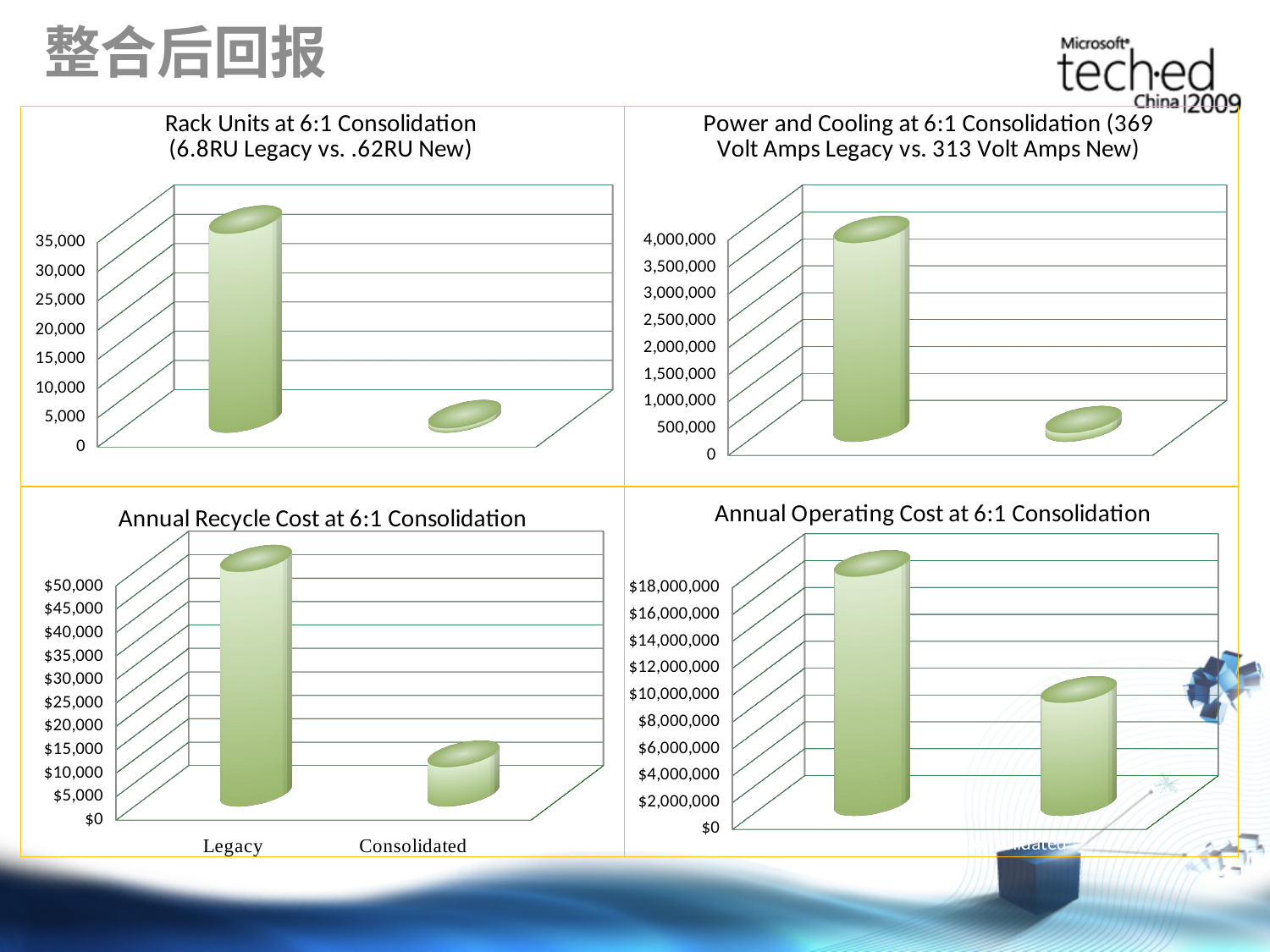
In the 'Annual Recycle Cost at 6:1 Consolidation' chart, is the value for Consolidated greater or less than $15,000? less How many bars are plotted in the 'Rack Units at 6:1 Consolidation' chart? 2 How many charts are shown on the slide? 4 In the 'Power and Cooling at 6:1 Consolidation' chart, is the value of the right-hand bar greater or less than 500,000? less Do the values in the 'Power and Cooling at 6:1 Consolidation' chart rise or fall from left to right? fall In the 'Annual Operating Cost at 6:1 Consolidation' chart, which bar is taller, the left-hand bar or the right-hand bar? the left-hand bar In the 'Annual Operating Cost at 6:1 Consolidation' chart, is the value of the right-hand bar greater or less than $12,000,000? less What kind of chart is the 'Annual Recycle Cost at 6:1 Consolidation' chart? bar chart In the 'Annual Recycle Cost at 6:1 Consolidation' chart, which category has the higher value, Legacy or Consolidated? Legacy